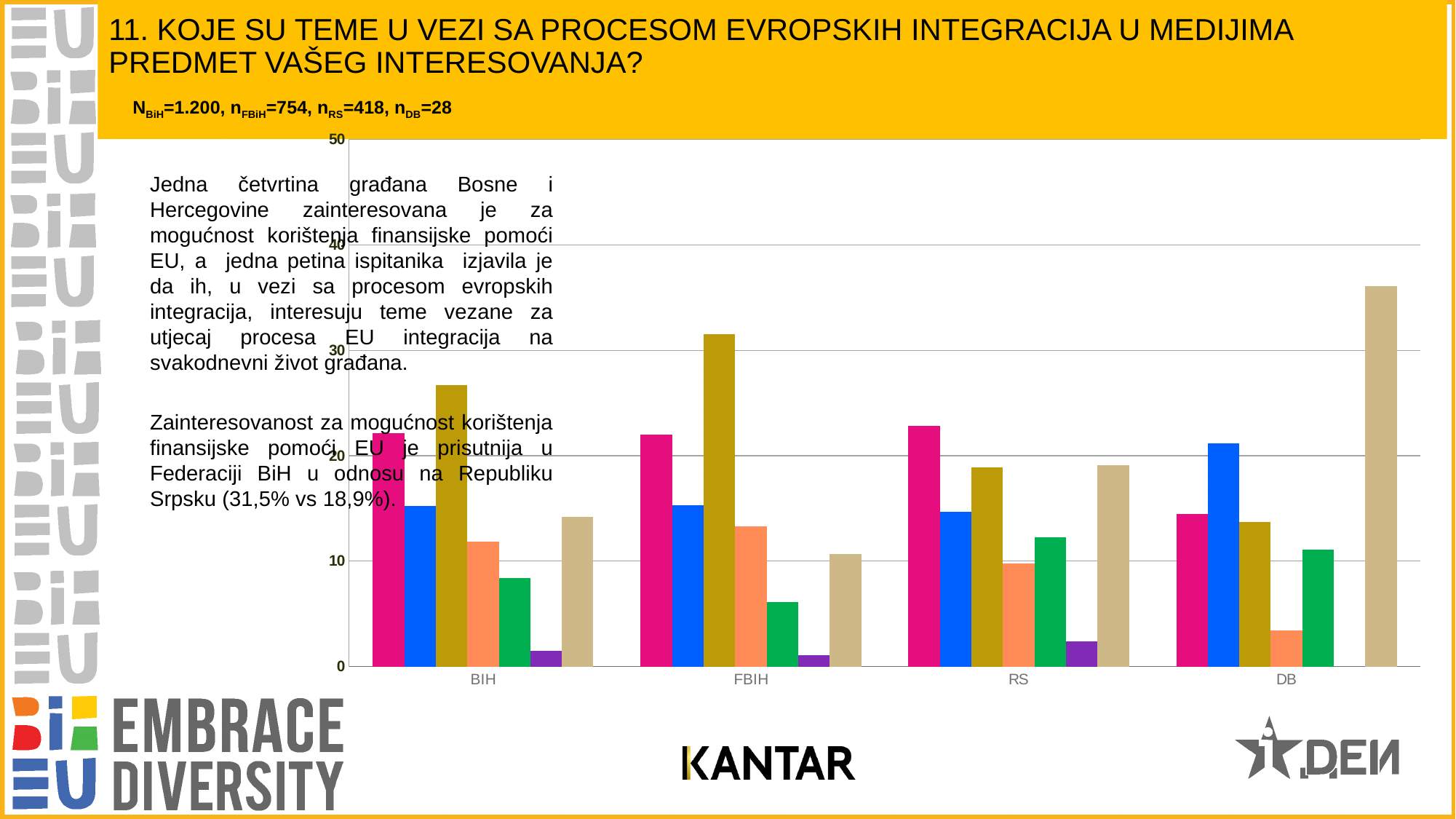
How many categories are shown on the x axis of the chart? 4 How many bars are shown for the BIH category? 7 Is the tallest bar in the FBIH group greater or less than 30? greater Is the tallest bar in the BIH group greater or less than 30? less Which is taller: the tallest bar in the FBIH group or the tallest bar in the RS group? FBIH What is the highest value shown on the y axis of the chart? 50 Is the tallest bar in the RS group greater or less than 20? greater According to the slide text, what is the share of interest in using EU financial assistance in the Federation of BiH compared with Republika Srpska? 31,5% vs 18,9% What kind of chart is shown on the slide? bar chart Which category on the x axis contains the tallest bar in the chart? DB